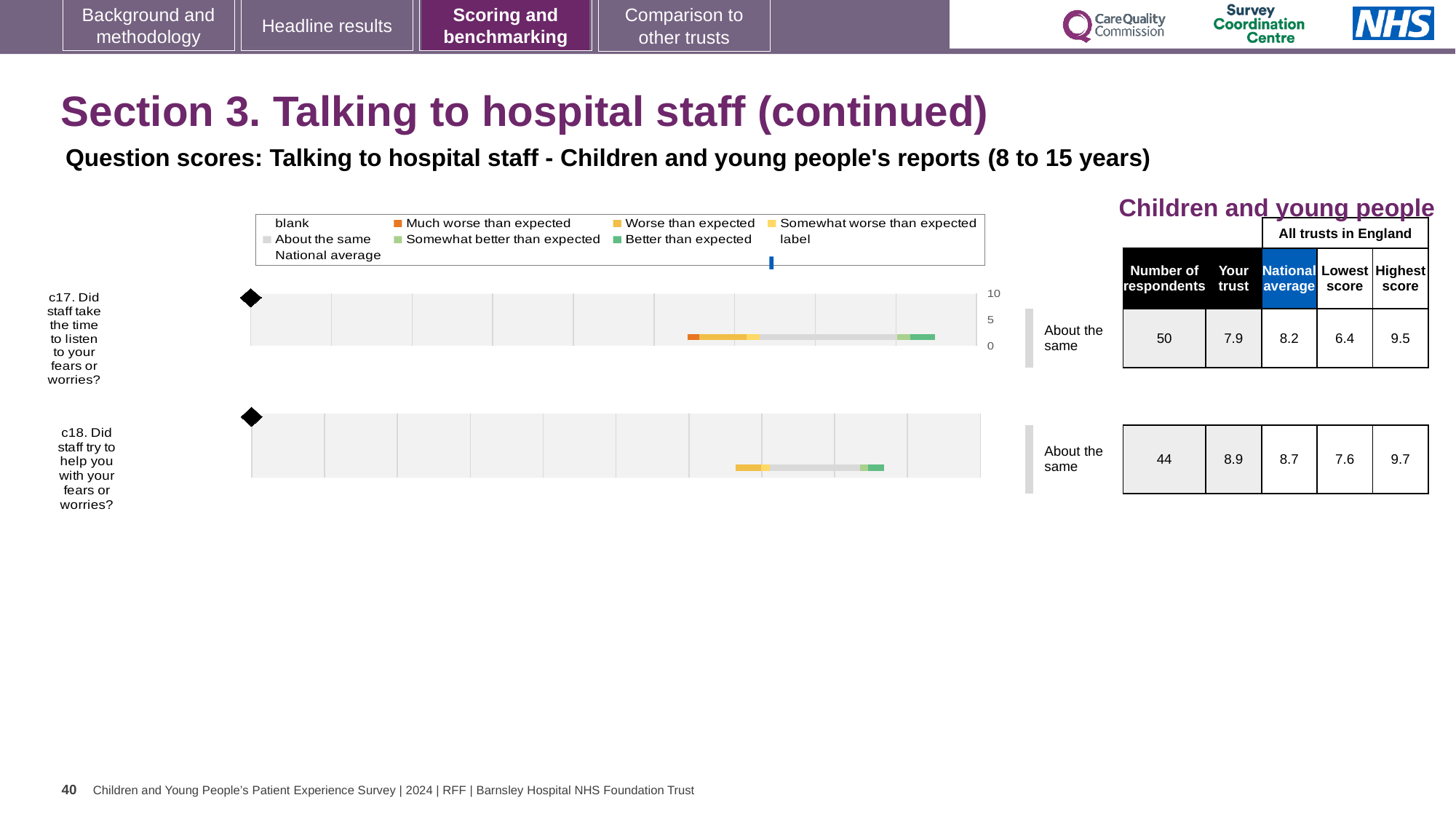
How many questions (rows) are plotted on the slide's charts? 2 For c18, which is higher: the trust's score or the national average? Your trust How many respondents answered question c17? 50 How many entries does the chart legend list? 9 What is the national average for c18 (Did staff try to help you with your fears or worries?)? 8.7 For c17, which is higher: the trust's score or the national average? National average What kind of chart is used to show the benchmark ranges for questions c17 and c18? bar chart What is the highest score across all trusts in England for c18? 9.7 What benchmark category is shown next to the chart for c18? About the same Is the trust's score for c17 greater or less than 5 on the chart axis? greater What is the difference between the highest and lowest scores for c17? 3.1 What is the 'Your trust' score for c17 (Did staff take the time to listen to your fears or worries?)? 7.9